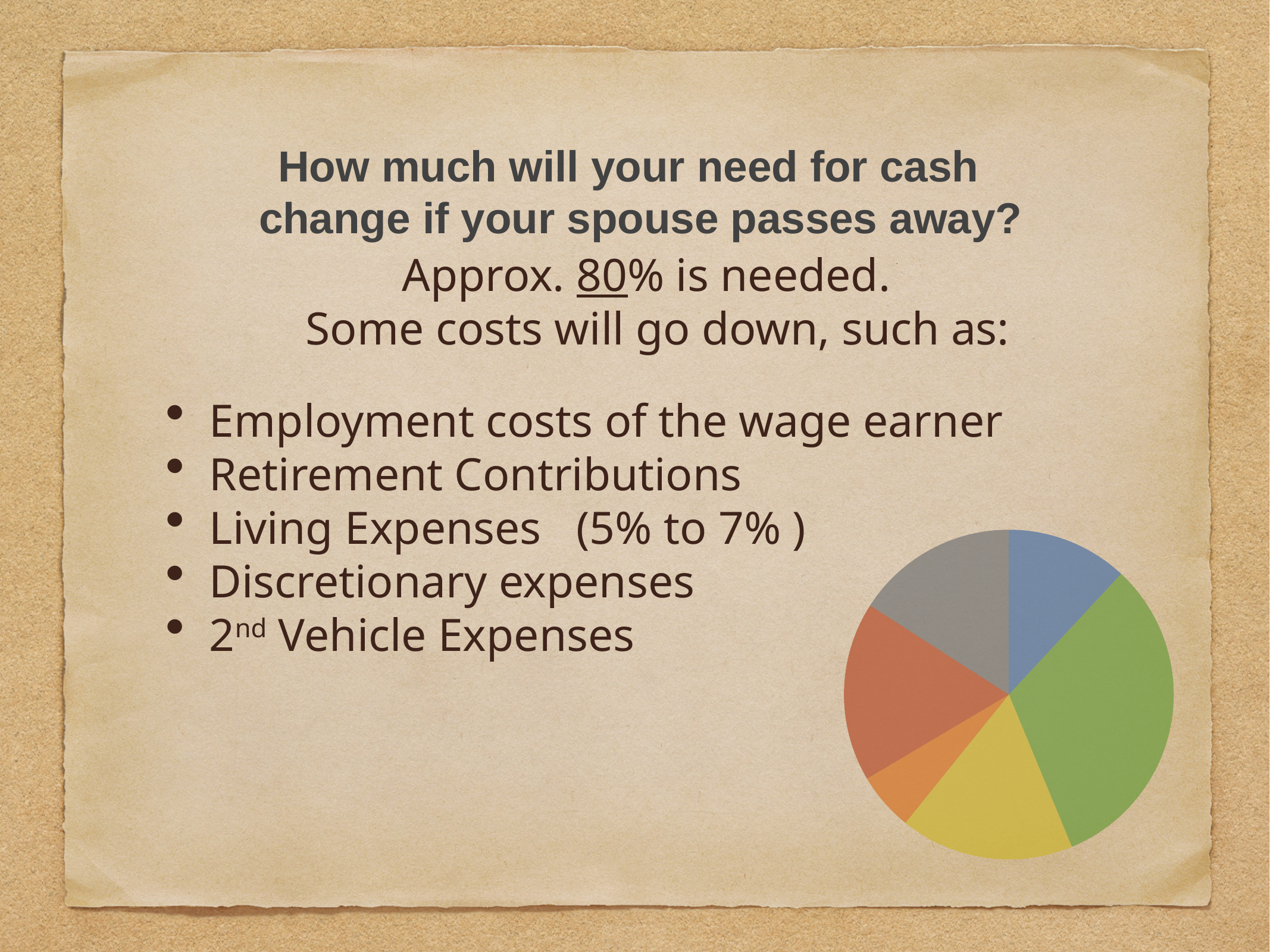
What kind of chart is shown on the slide? pie chart Which is larger in the pie chart, the green slice or the blue slice? green Which is larger in the pie chart, the green slice or the gray slice? green Which colour slice is the largest in the pie chart? green Does the pie chart display a legend? No Does the pie chart show data labels on its slices? No